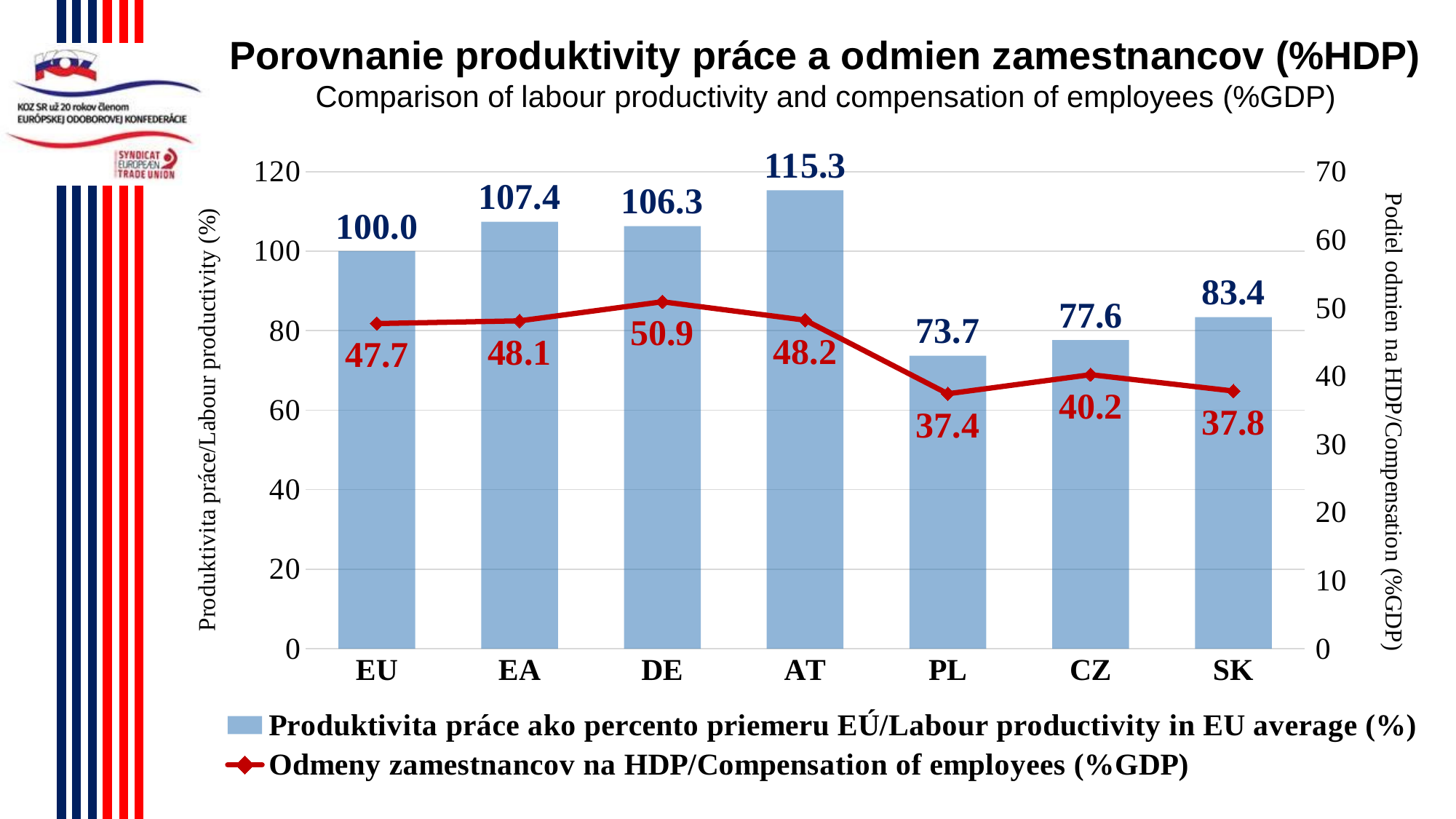
What is the difference in labour productivity between AT and PL? 41.6 Is the labour productivity value for CZ greater or less than 80? less What is the labour productivity value for SK? 83.4 Which has a higher compensation of employees (%GDP), CZ or SK? CZ What is the labour productivity value for AT? 115.3 How many categories are shown on the x axis? 7 How many series does the legend list? 2 What is the compensation of employees (%GDP) value for DE? 50.9 Which category has the lowest compensation of employees (%GDP)? PL What is the difference in compensation of employees (%GDP) between DE and PL? 13.5 Which category has the highest labour productivity? AT What kind of chart is used for the labour productivity series? bar chart